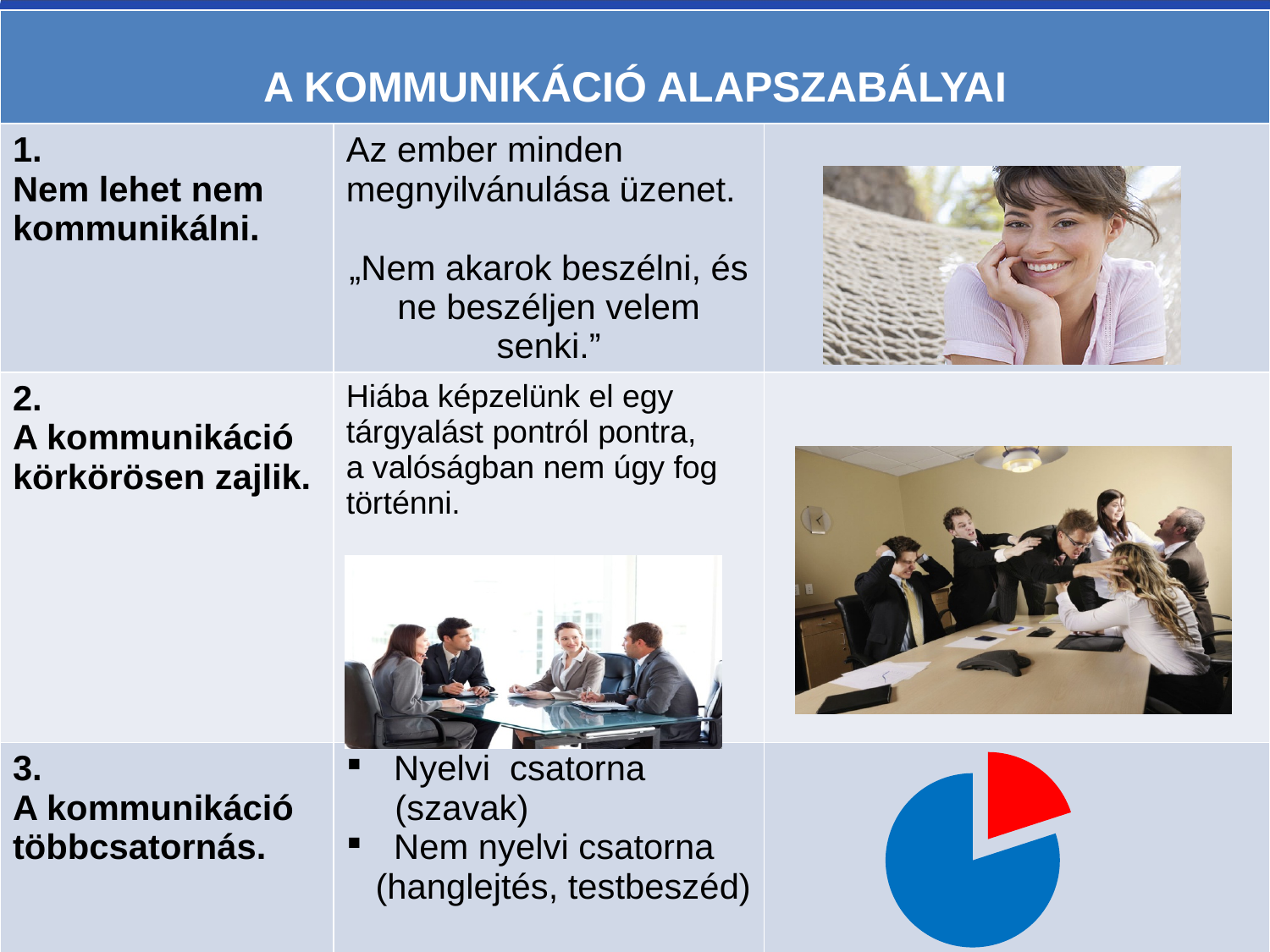
Does the pie chart on the slide have a legend? no Which colour slice takes up the smallest share of the pie chart? red Which colour slice takes up the largest share of the pie chart? blue Which slice of the pie chart is larger, the blue one or the red one? blue What two colours are used for the slices of the pie chart? blue and red How many slices does the pie chart on the slide have? 2 What kind of chart is shown in the bottom-right cell of the slide? pie chart